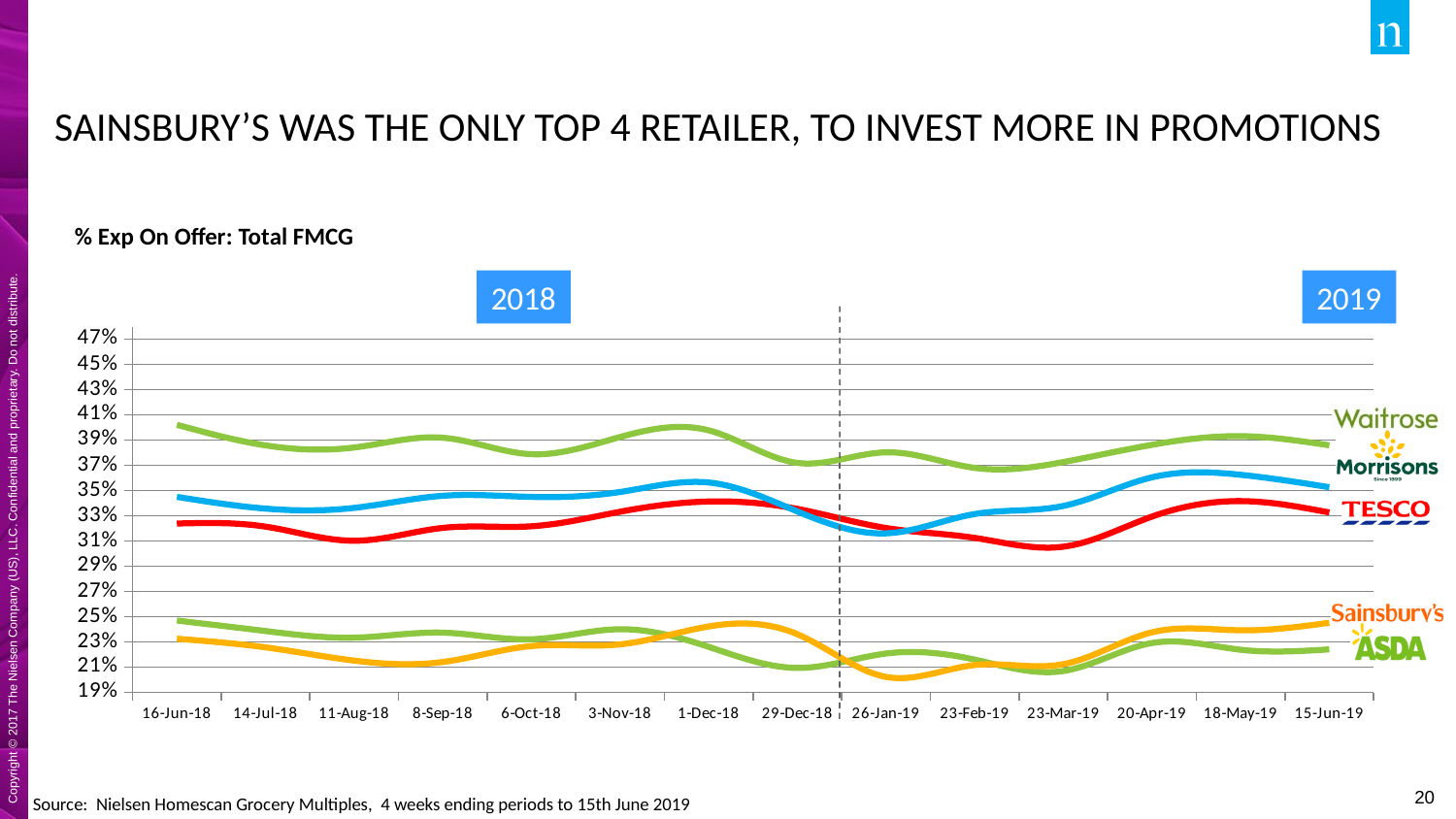
Is the value for Tesco at 23-Mar-19 greater or less than 33%? less Which retailer has the highest % Exp On Offer across the whole period? Waitrose Is the value for Waitrose at 16-Jun-18 greater or less than 37%? greater At 1-Dec-18, which is higher: Morrisons or Tesco? Morrisons What is the title of the chart? % Exp On Offer: Total FMCG Does the Sainsbury's line rise or fall from 23-Mar-19 to 15-Jun-19? Rise How many dates are labelled along the x axis of the chart? 14 Which retailer has the lowest % Exp On Offer at 15-Jun-19? ASDA How many retailers (lines) are plotted on the chart? 5 Is the value for Sainsbury's at 26-Jan-19 greater or less than 21%? less At 15-Jun-19, which is higher: Sainsbury's or ASDA? Sainsbury's What kind of chart is shown on the slide? Line chart